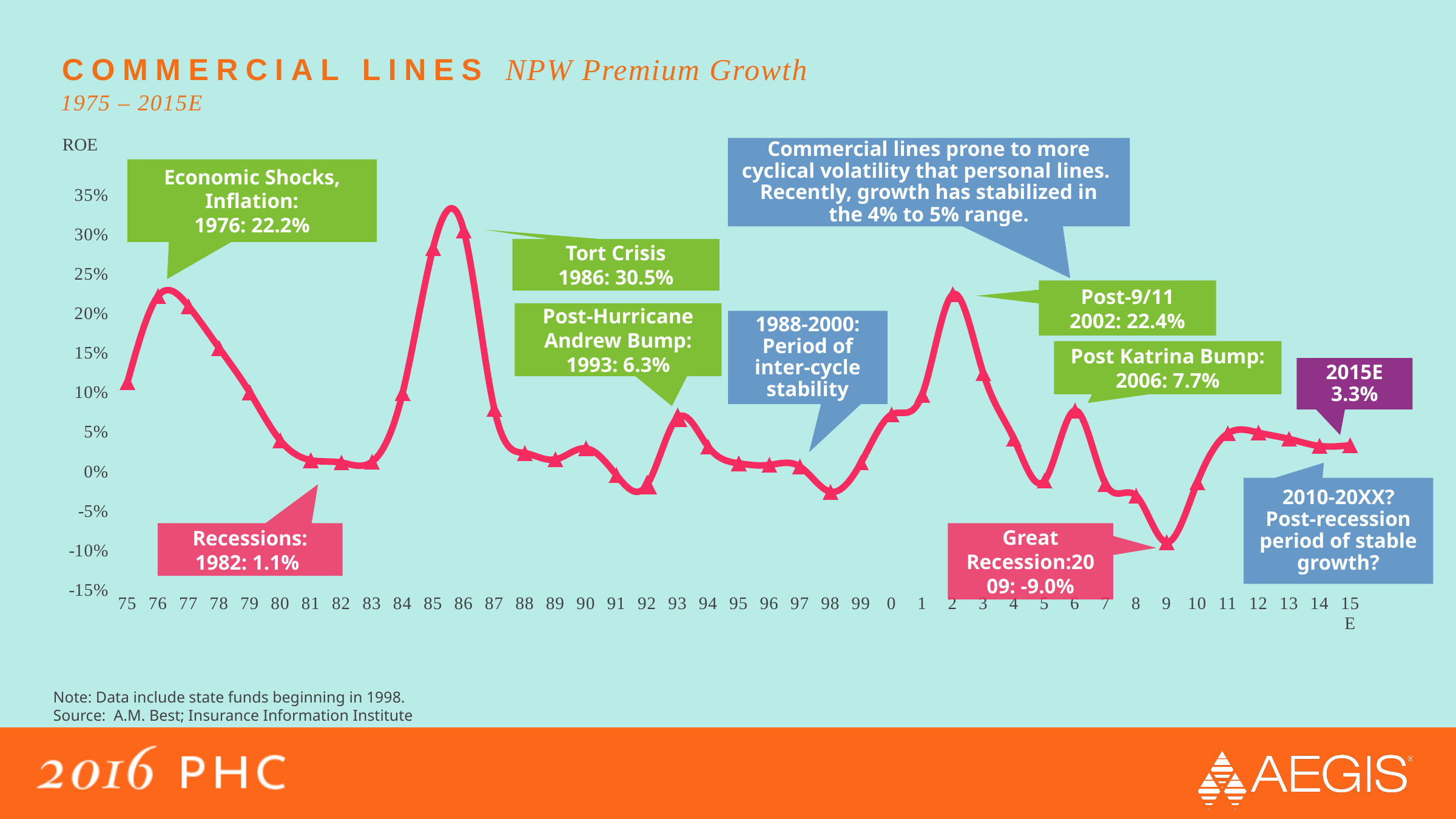
Which year has the highest value on the chart? 1986 What is the difference between the 1986 value (30.5%) and the 1976 value (22.2%)? 8.3 percentage points Do the values rise or fall from 2002 to 2009? fall What label is shown on the vertical axis? ROE What was the NPW premium growth value in 1986 (Tort Crisis)? 30.5% What is the estimated value for 2015E? 3.3% What value is given for the Post Katrina Bump in 2006? 7.7% Which year has the lowest value on the chart? 2009 Is the value for 1998 greater or less than 0%? less What kind of chart is shown on the slide? line chart Which is larger, the value for 1986 or the value for 2002? 1986 What value is given for 2009 (Great Recession)? -9.0%